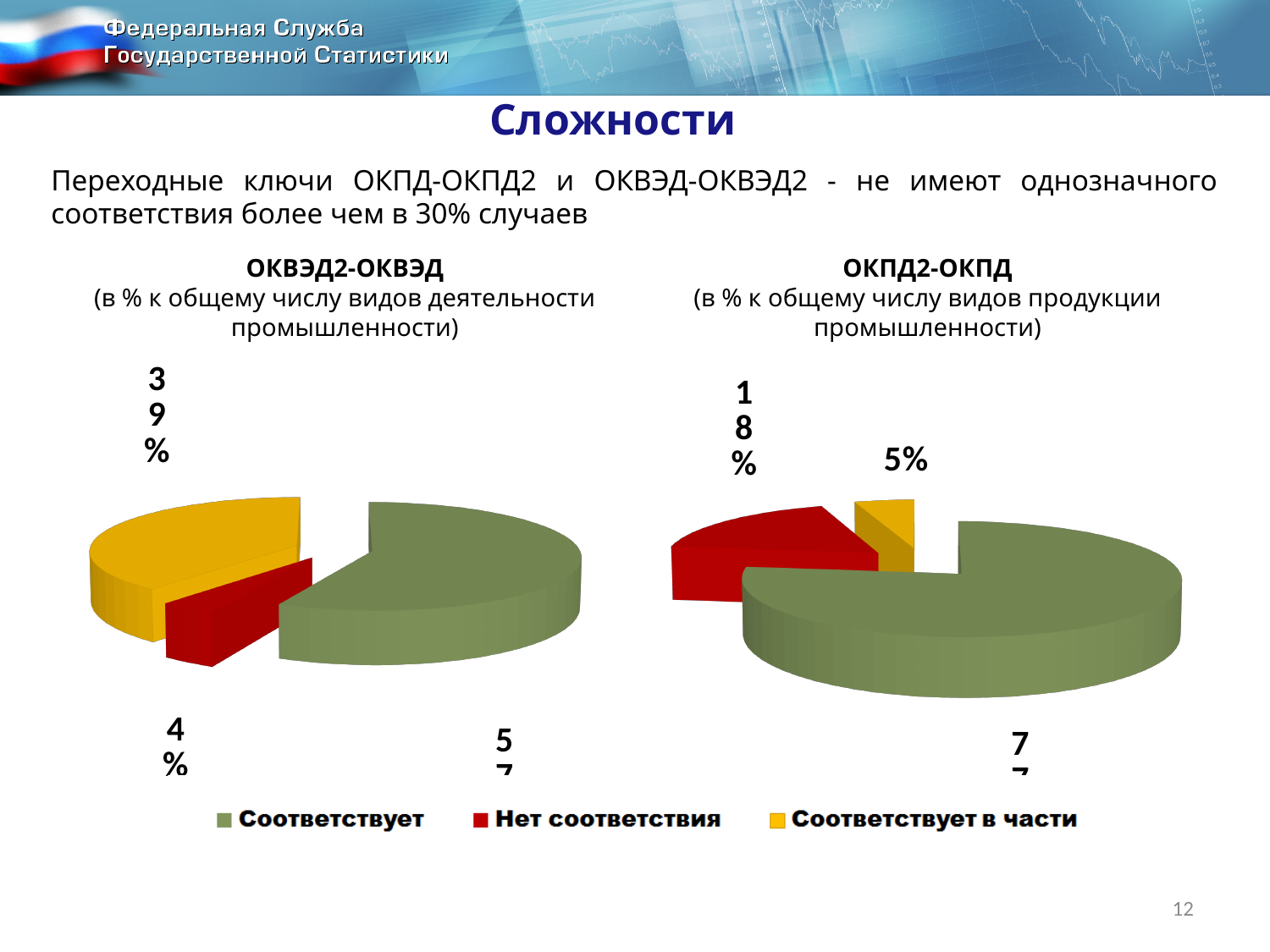
In the ОКВЭД2-ОКВЭД chart, what is the difference between Соответствует в части and Нет соответствия? 35% In the ОКПД2-ОКПД chart, which category has the smallest slice? Соответствует в части In the ОКПД2-ОКПД chart, what is the value for Соответствует в части? 5% What kind of chart is used on this slide for ОКВЭД2-ОКВЭД and ОКПД2-ОКПД? Pie chart In the ОКВЭД2-ОКВЭД chart, what is the value for Нет соответствия? 4% In the ОКПД2-ОКПД chart, what is the value for Нет соответствия? 18% In the ОКВЭД2-ОКВЭД chart, which category has the smallest slice? Нет соответствия What colour represents Нет соответствия in the pie charts? Red In the ОКПД2-ОКПД chart, what is the difference between Нет соответствия and Соответствует в части? 13% How many categories does the legend list for the pie charts? 3 In the ОКВЭД2-ОКВЭД chart, what is the value for Соответствует в части? 39% In the ОКВЭД2-ОКВЭД chart, which category has the largest slice? Соответствует